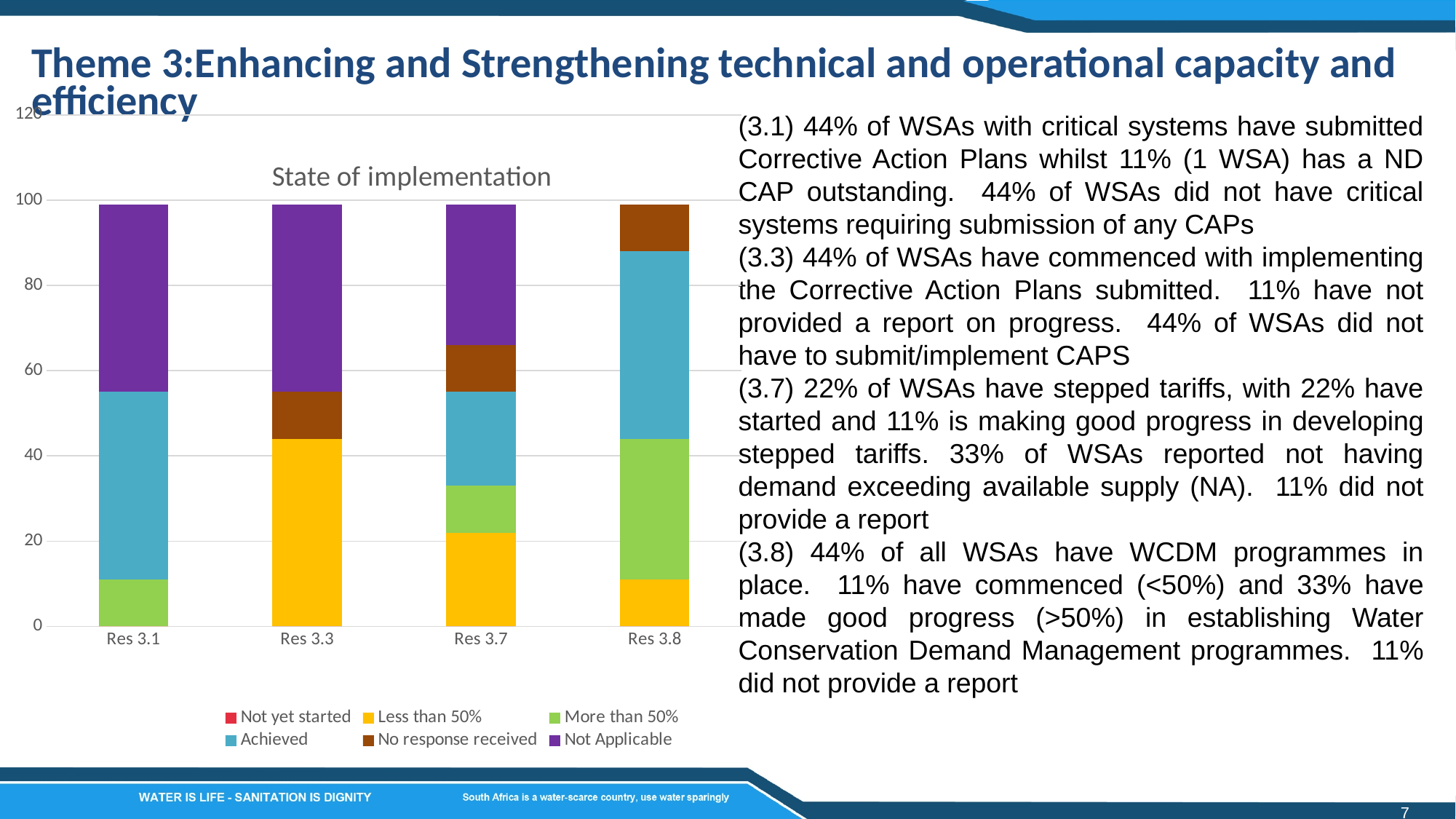
Which category has the largest 'Less than 50%' segment? Res 3.3 Is the 'Less than 50%' value for Res 3.3 greater or less than 40? greater What is the title of the chart? State of implementation What kind of chart is shown on the slide? Stacked bar chart Is the 'Less than 50%' segment larger for Res 3.3 or Res 3.7? Res 3.3 Is the 'More than 50%' value for Res 3.1 greater or less than 20? less How many categories are shown on the x axis of the chart? 4 Which category has the largest 'More than 50%' segment? Res 3.8 Is the 'Achieved' segment larger for Res 3.7 or Res 3.8? Res 3.8 Is the top of the stacked bar for Res 3.1 greater or less than 80? greater Which category has no 'Not Applicable' segment in its bar? Res 3.8 How many series does the chart legend list? 6